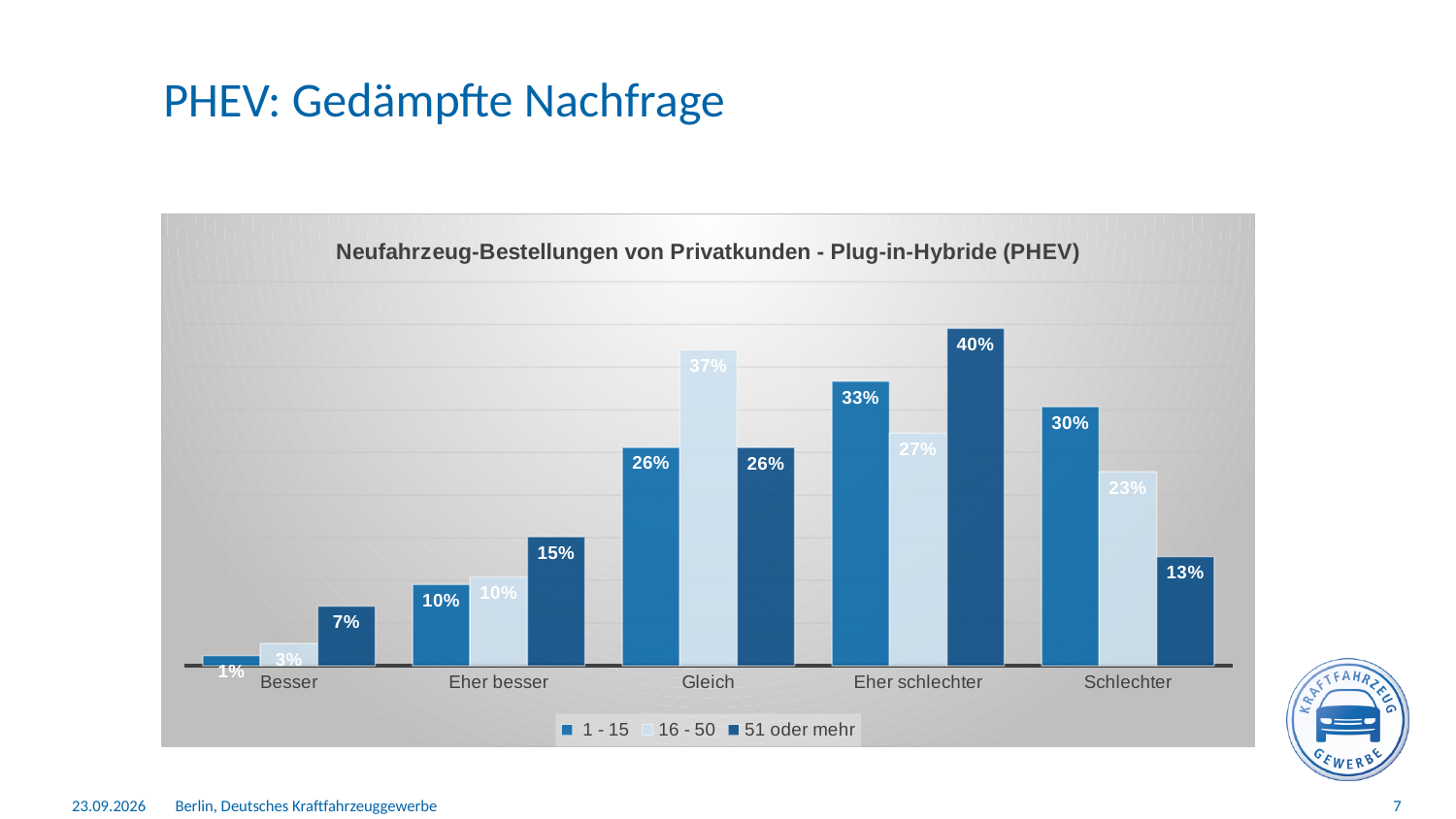
What is the value for the "51 oder mehr" series in the "Eher schlechter" category? 40% What is the value for the "1 - 15" series in the "Schlechter" category? 30% How many series does the legend list? 3 What is the difference between the "51 oder mehr" value and the "1 - 15" value in the "Eher besser" category? 5% In which category does the "51 oder mehr" series have its lowest value? Besser What type of chart is shown on the slide? Bar chart In which category does the "1 - 15" series reach its highest value? Eher schlechter What is the value for the "16 - 50" series in the "Gleich" category? 37% Which is larger in the "Schlechter" category: the "16 - 50" value or the "51 oder mehr" value? 16 - 50 What is the difference between the "16 - 50" value and the "1 - 15" value in the "Gleich" category? 11% What is the title of the chart? Neufahrzeug-Bestellungen von Privatkunden - Plug-in-Hybride (PHEV) How many categories are shown on the x axis? 5